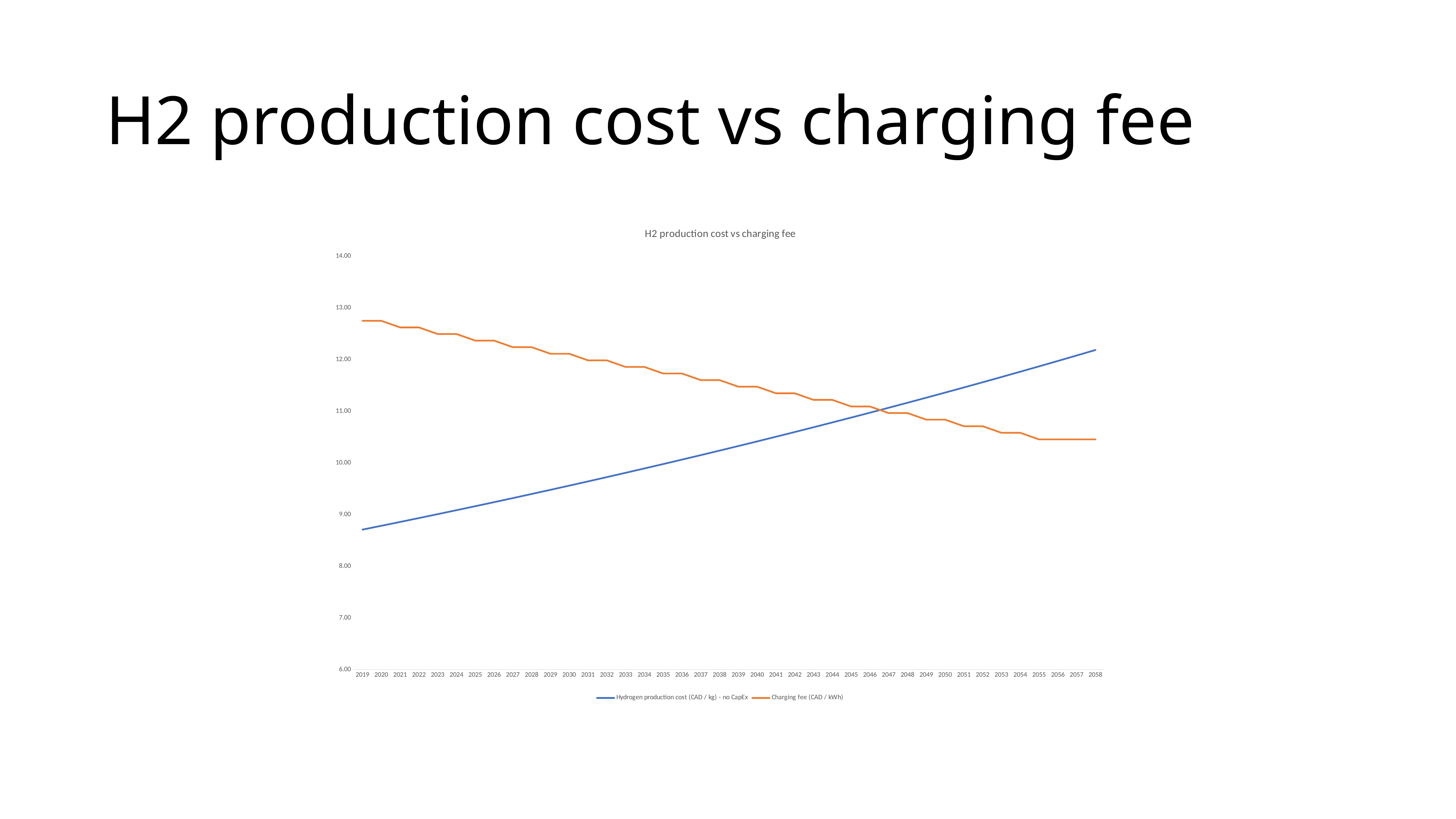
In 2019, which is larger: the Hydrogen production cost (CAD / kg) - no CapEx or the Charging fee (CAD / kWh)? Charging fee (CAD / kWh) Does the Hydrogen production cost (CAD / kg) - no CapEx series rise or fall from 2019 to 2058? rise Is the Charging fee (CAD / kWh) value for 2019 greater or less than 12.00? greater How many years are plotted along the x axis? 40 Does the Charging fee (CAD / kWh) series rise or fall from 2019 to 2058? fall What kind of chart is shown on the slide? line chart Is the Charging fee (CAD / kWh) value for 2058 greater or less than 11.00? less What is the title of the chart? H2 production cost vs charging fee Is the Hydrogen production cost (CAD / kg) - no CapEx value for 2058 greater or less than 12.00? greater How many series does the legend list? 2 Which series is drawn in orange? Charging fee (CAD / kWh)